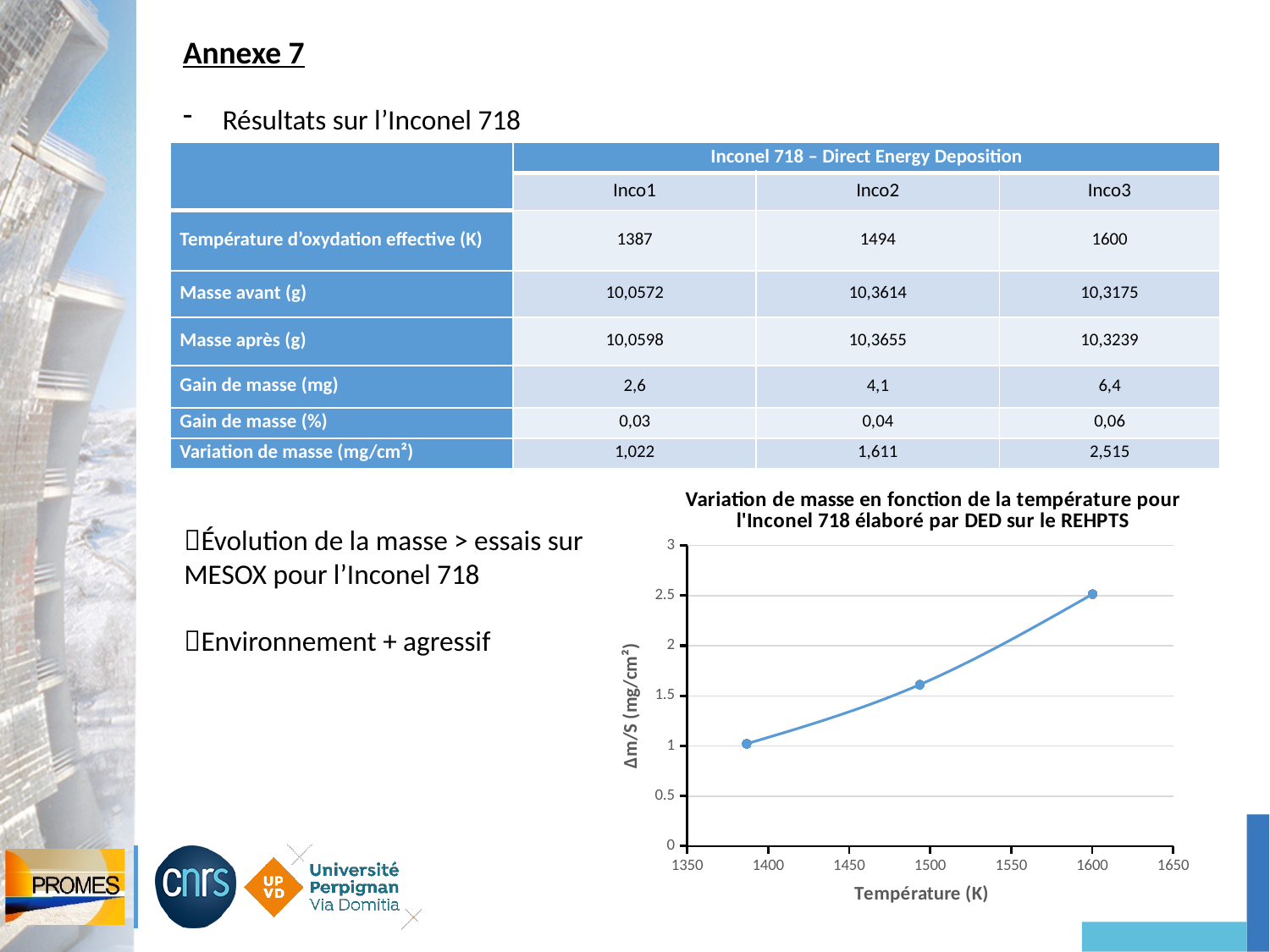
Is the value for the middle point (near 1500 K) greater or less than 1.5? greater What kind of chart is shown on the slide? line chart Is the value for the point at 1600 K greater or less than 2? greater Is the value for the leftmost point (near 1400 K) greater or less than 0.5? greater Which data point has the lowest mass variation: the one at the lowest, middle or highest temperature? the one at the lowest temperature Does the mass variation rise or fall as temperature increases along the x axis? rise Which data point has the highest mass variation: the one at the lowest, middle or highest temperature? the one at the highest temperature (1600 K) Which is larger: the mass variation at 1600 K or at the middle point near 1500 K? 1600 K What is the label of the x axis of the chart? Température (K) How many data points are plotted on the chart? 3